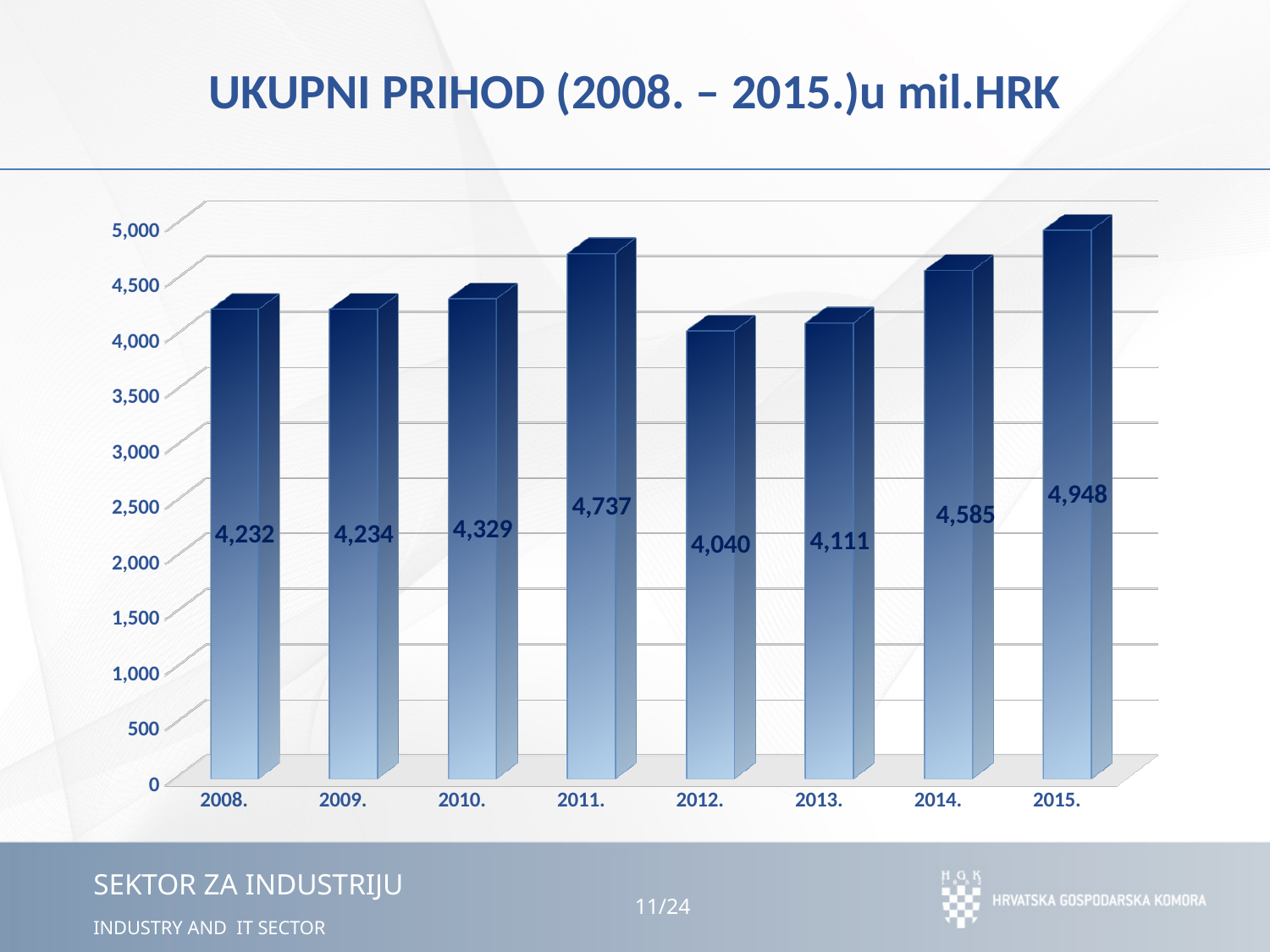
What is the value for 2011.? 4,737 What is the title of the chart? UKUPNI PRIHOD (2008. – 2015.)u mil.HRK What is the difference between the values for 2011. and 2010.? 408 What is the value for 2008.? 4,232 Which year has the lowest value? 2012. What is the value for 2014.? 4,585 Is the value for 2011. greater or less than 4,500? greater Which year has the highest value? 2015. What kind of chart is shown on the slide? bar chart How many years are shown on the x axis? 8 Which is larger, the value for 2013. or the value for 2014.? 2014. What is the difference between the values for 2015. and 2012.? 908